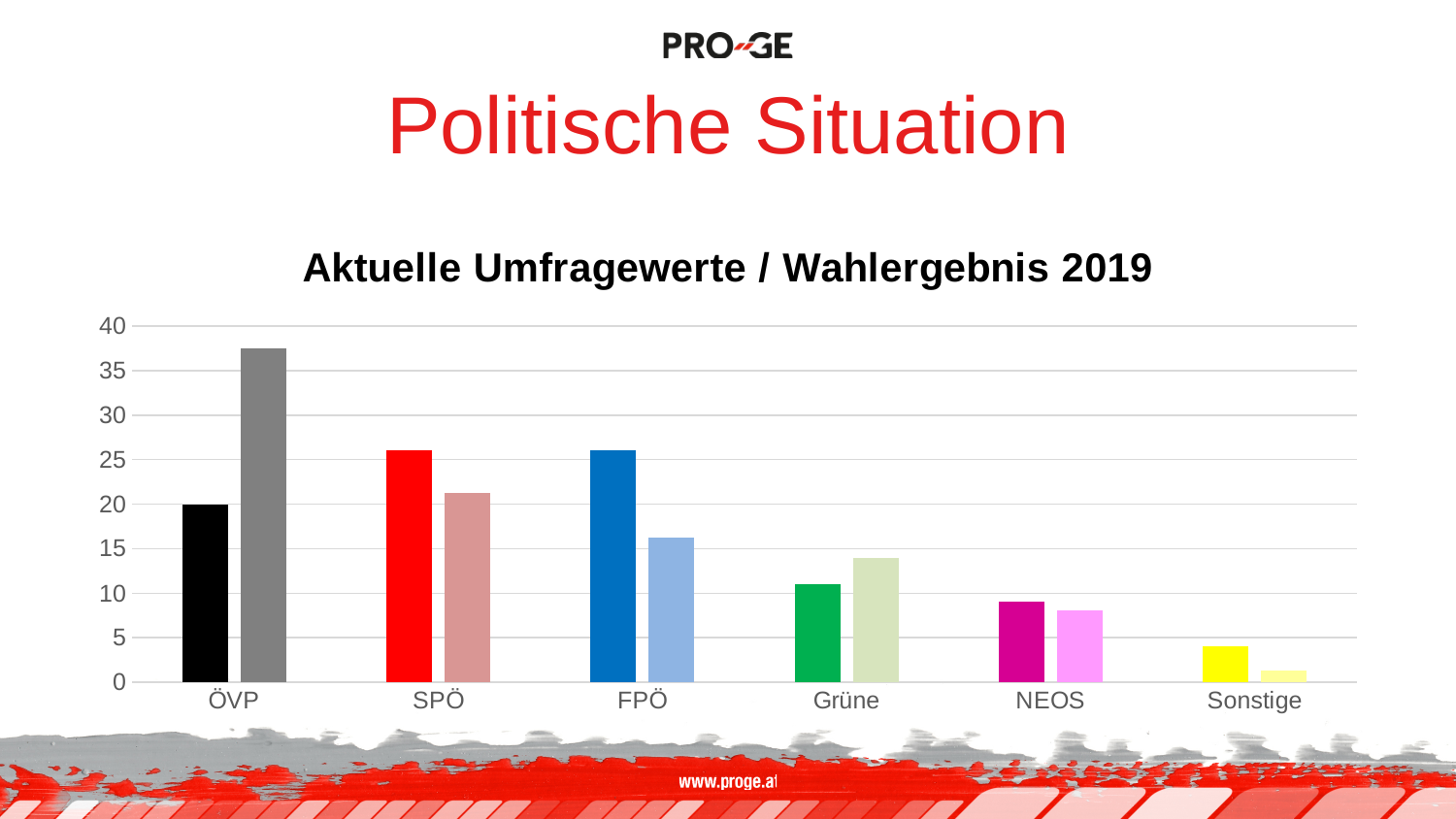
Which category contains the shortest bar in the chart? Sonstige Is the value of the left (red) bar for SPÖ greater or less than 20? greater Is the value of the left (magenta) bar for NEOS greater or less than 10? less For Sonstige, which bar is taller, the left (yellow) bar or the right (light yellow) bar? the left (yellow) bar How many bars are shown for each category in the chart? 2 For ÖVP, which bar is taller, the left (black) bar or the right (grey) bar? the right (grey) bar What is the title of the chart? Aktuelle Umfragewerte / Wahlergebnis 2019 How many categories are shown on the x axis of the chart? 6 Which category contains the tallest bar in the chart? ÖVP Is the value of the right (light blue) bar for FPÖ greater or less than 20? less What kind of chart is shown on the slide? bar chart